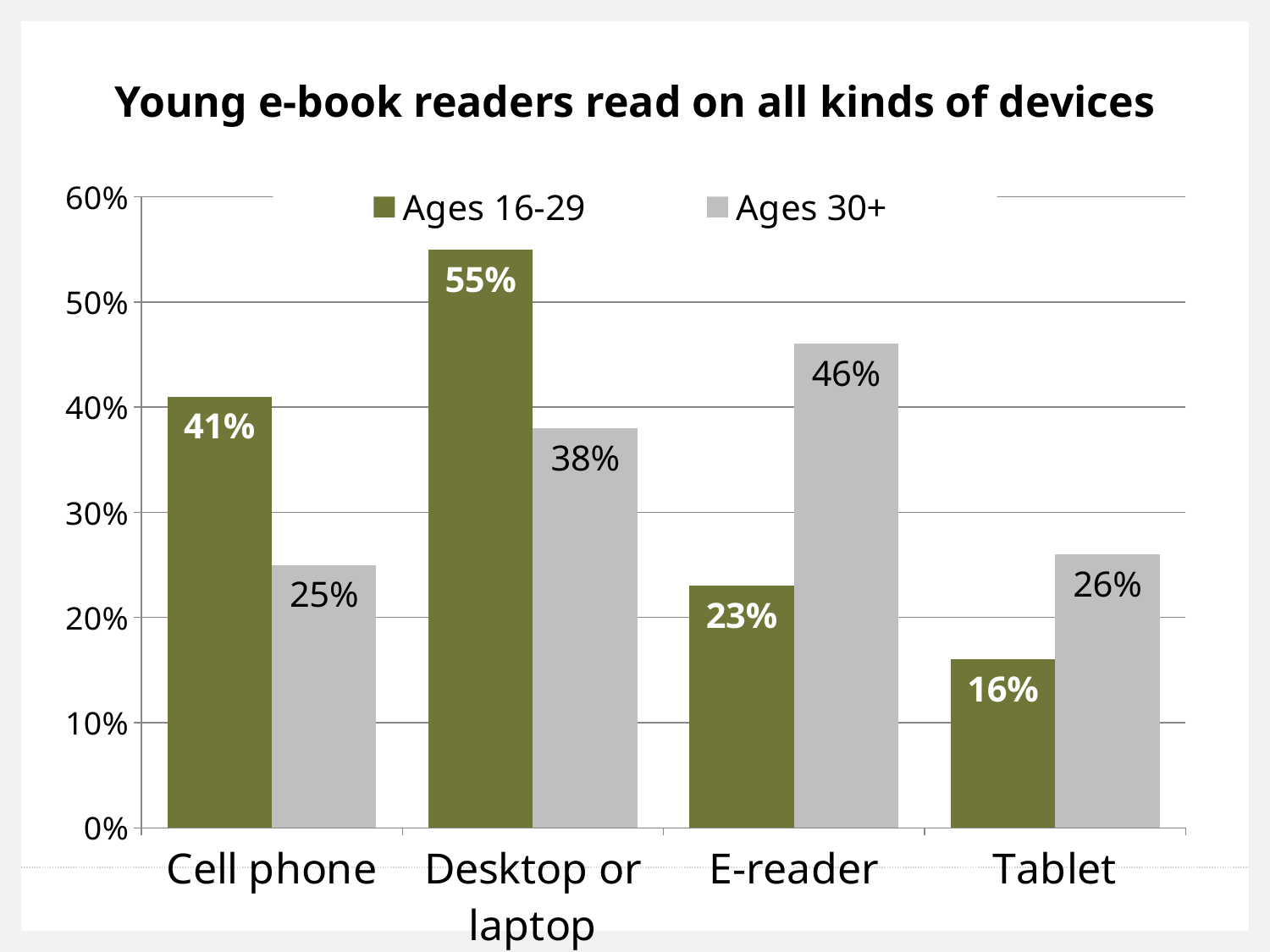
Which device has the highest value for Ages 16-29? Desktop or laptop What is the difference between Ages 16-29 and Ages 30+ for Desktop or laptop? 17% What is the value for Ages 30+ for E-reader? 46% How many series does the legend list? 2 What is the title of the chart? Young e-book readers read on all kinds of devices What kind of chart is shown? bar chart What is the value for Ages 30+ for Tablet? 26% Which device has the lowest value for Ages 30+? Cell phone Is the value for Ages 16-29 for Tablet greater or less than 20%? less Which is larger for E-reader: Ages 16-29 or Ages 30+? Ages 30+ What is the value for Ages 16-29 for Cell phone? 41% How many device categories are shown on the x axis? 4